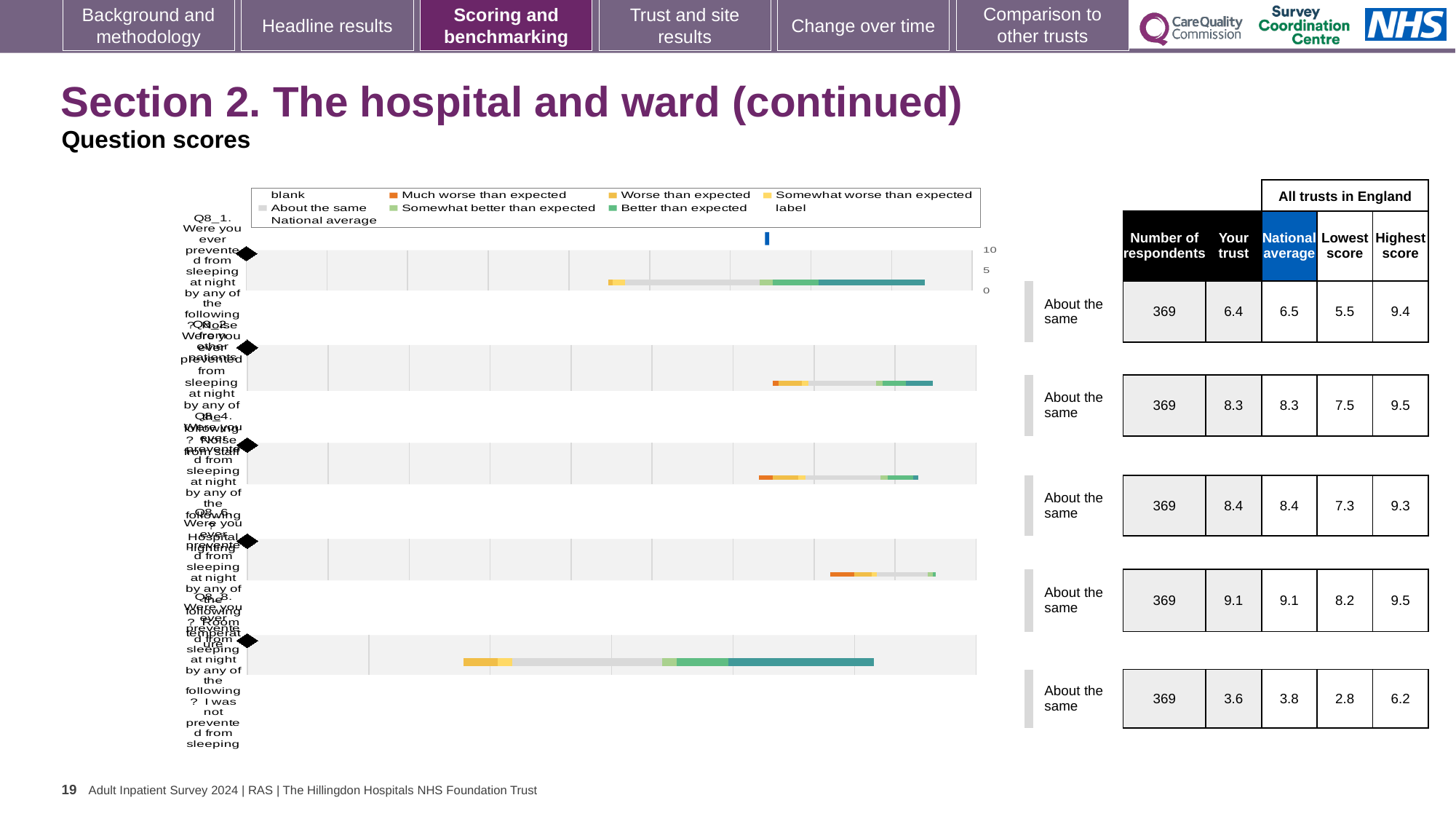
Which row has the highest 'Your trust' score? the fourth row from the top (9.1) How many question rows are plotted in the chart? 5 What is the 'National average' score for the bottom row of the chart? 3.8 What kind of chart is shown on the slide? bar chart What is the 'Lowest score' for the third row from the top? 7.3 For the top row, what is the difference between the 'Highest score' and the 'Lowest score'? 3.9 For the top row, which is larger: the 'Your trust' score or the 'National average'? National average How many respondents are listed for the second row from the top? 369 For the bottom row, how much higher is the 'National average' than the 'Your trust' score? 0.2 What is the 'Your trust' score for the top row of the chart? 6.4 Which row has the lowest 'Your trust' score? the bottom row (3.6) What benchmark label is shown next to each row of the chart? About the same